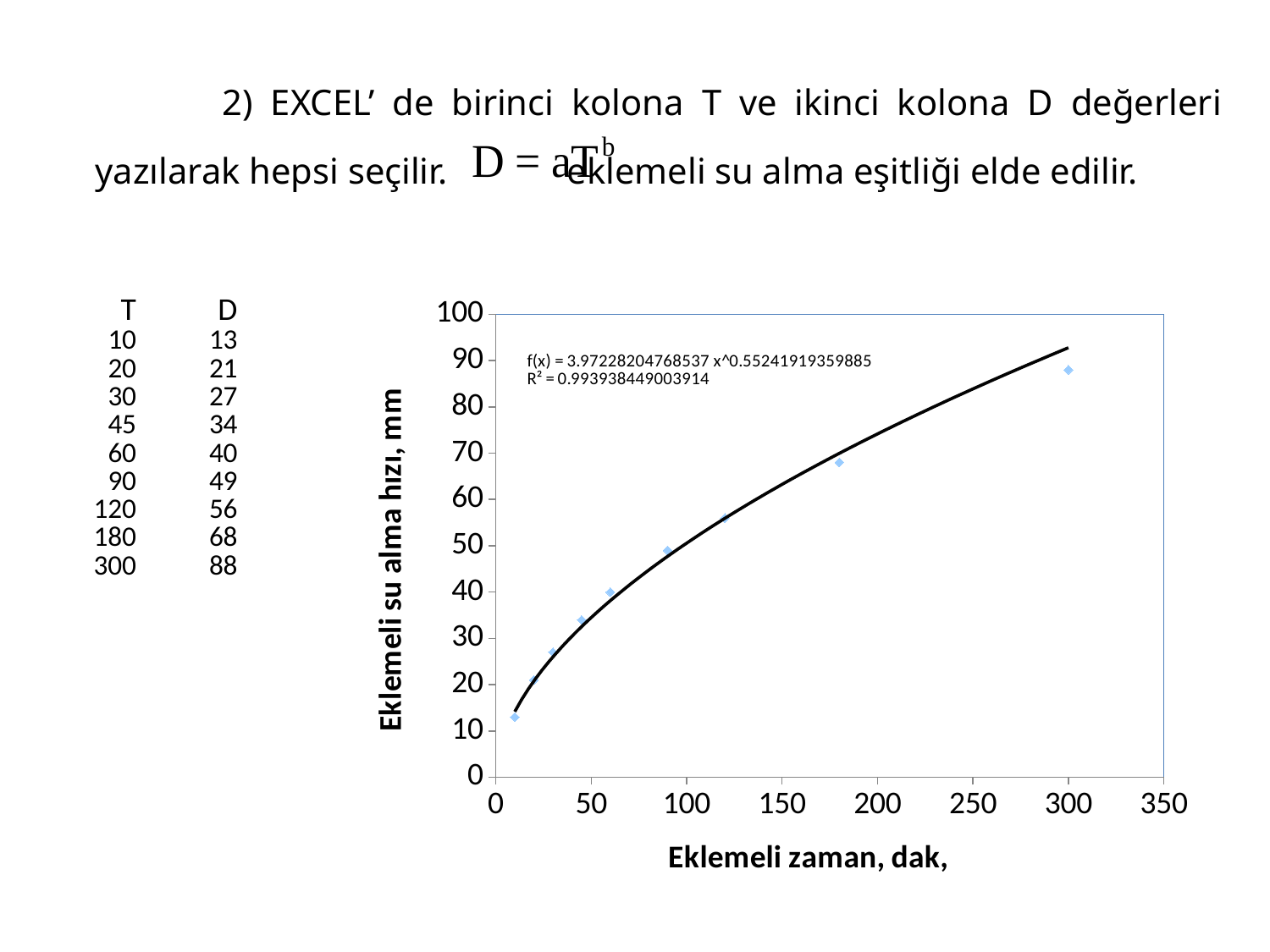
Is the plotted value at x = 180 greater or less than 60? greater What R² value is printed on the chart for the trendline? 0.993938449003914 What is the title of the chart's vertical axis? Eklemeli su alma hızı, mm Which plotted point is higher: the one at x = 120 or the one at x = 180? x = 180 At which x-axis value (Eklemeli zaman, dak) is the plotted point lowest? 10 Do the plotted values rise or fall as the x-axis value (Eklemeli zaman) increases? rise Is the plotted value at x = 300 greater or less than 90? less At which x-axis value (Eklemeli zaman, dak) is the plotted point highest? 300 How many data points are plotted on the chart? 9 According to the table on the slide, what is the D value for T = 90? 49 Is the plotted value at x = 10 greater or less than 20? less What kind of chart is shown on the slide? scatter chart